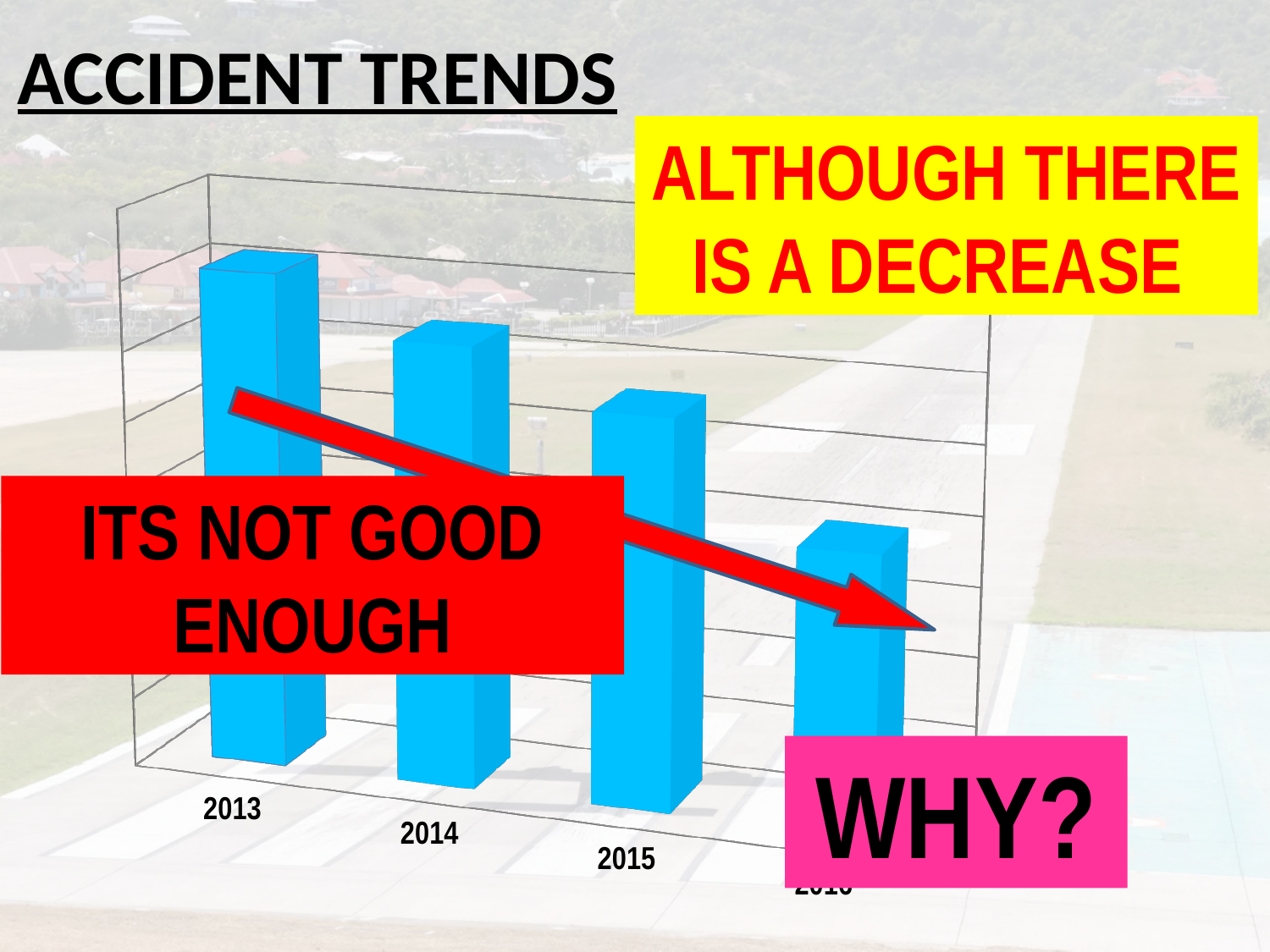
Do the bar values rise or fall from 2013 to 2015? fall Is the bar for 2015 taller or shorter than the bar for 2013? shorter What colour are the bars in the chart? blue Which of the labelled years, 2013, 2014 or 2015, has the shortest bar? 2015 Which year has the tallest bar in the chart? 2013 Which bar is taller, 2013 or 2014? 2013 What is the title of the slide containing the chart? ACCIDENT TRENDS What kind of chart is shown on the slide? bar chart How many bars are plotted in the chart? 4 Which bar is taller, 2014 or 2015? 2014